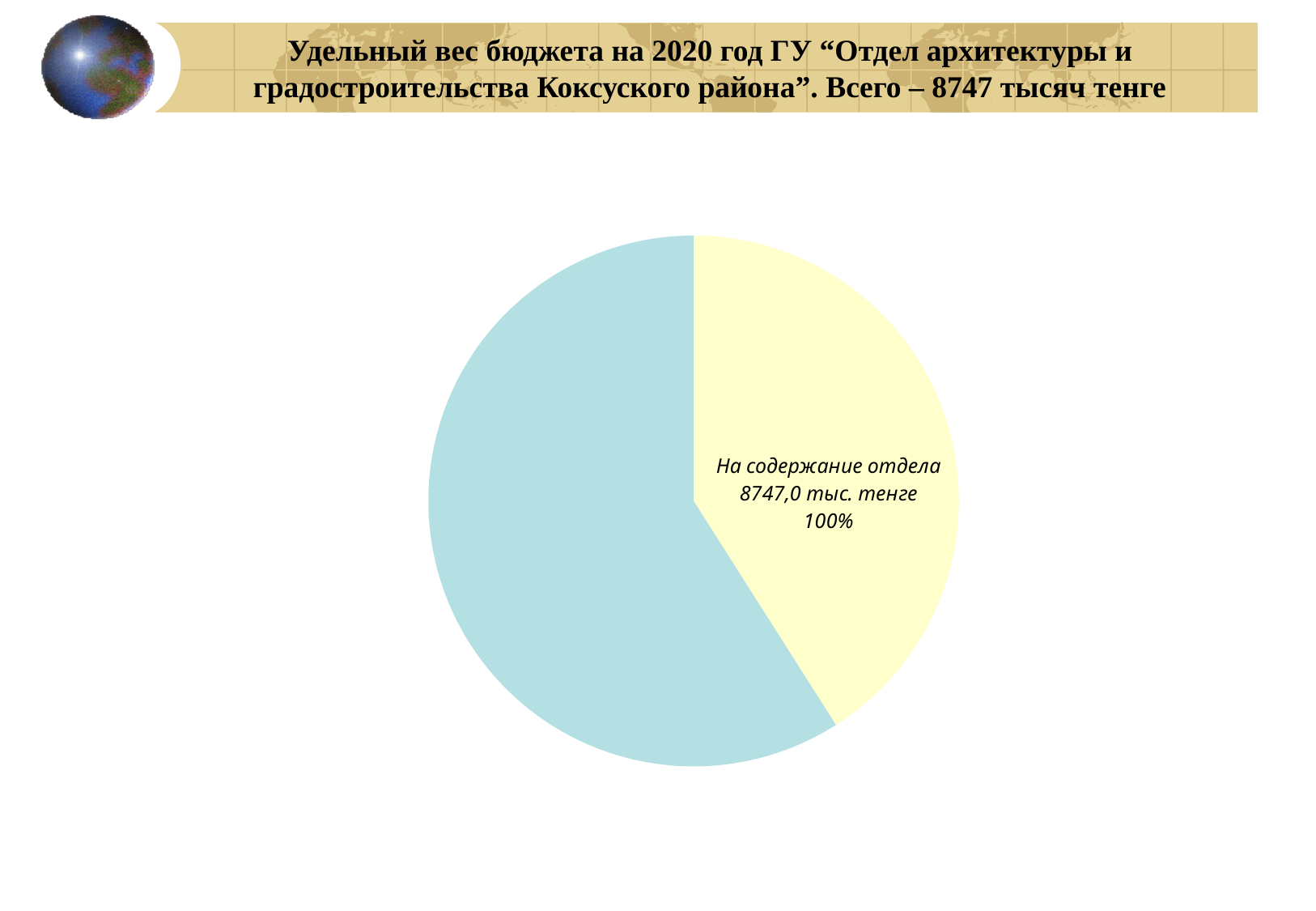
Which slice is larger by area, the light blue one or the yellow one? the light blue one What value is printed on the slice labelled "На содержание отдела"? 8747,0 тыс. тенге What kind of chart is shown on the slide? pie chart What colour is the slice labelled "На содержание отдела"? yellow What percentage is printed on the slice labelled "На содержание отдела"? 100% What total amount is stated in the slide title? 8747 тысяч тенге How many slices does the pie chart show? 2